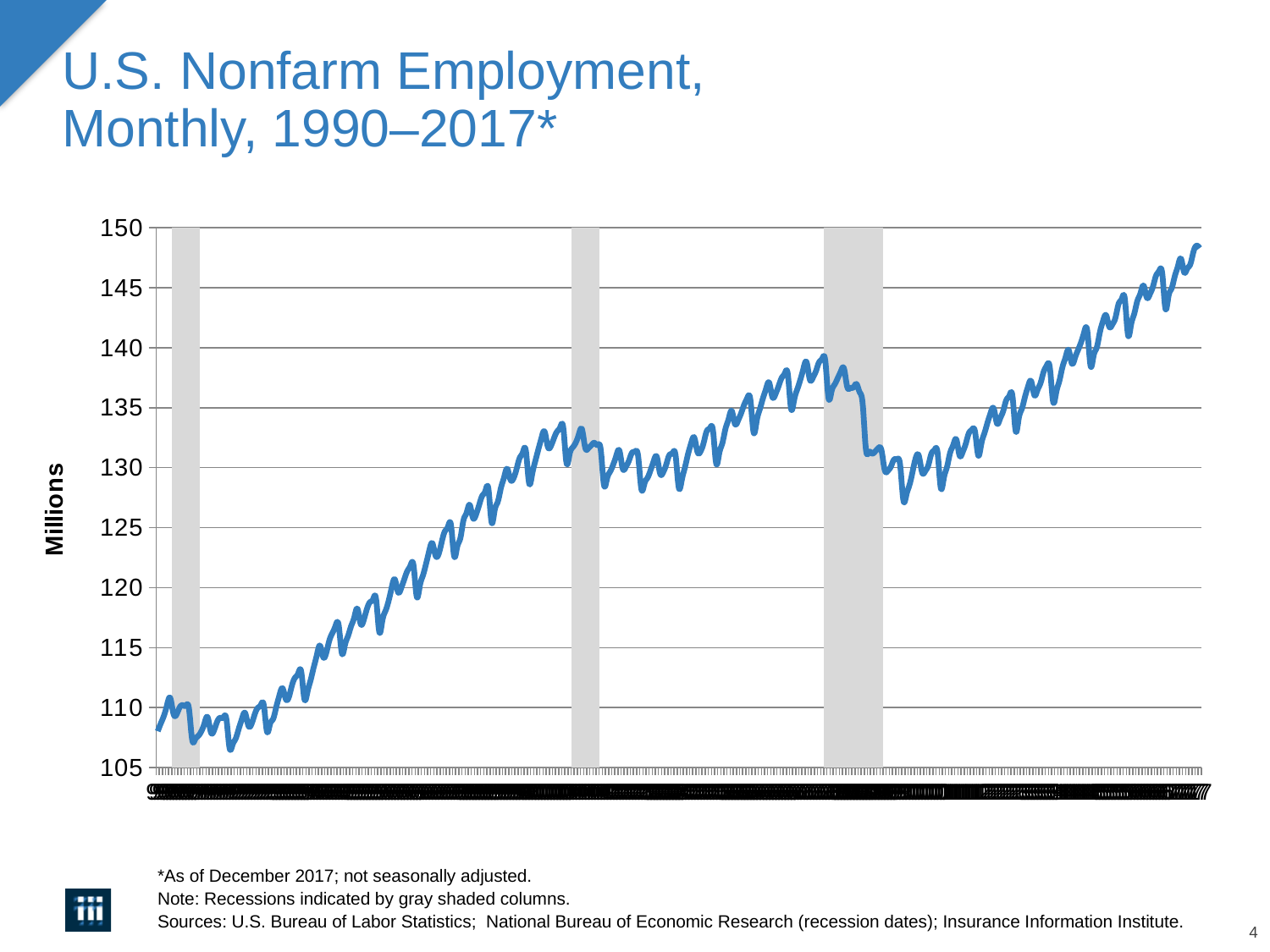
How many gray shaded recession columns are shown on the chart? 3 What kind of chart is shown on the slide? line chart What unit is given on the vertical axis of the chart? Millions Is the value at the start of the series (1990) greater or less than 115? less Is the value at the end of the series greater or less than 150? less Is the lowest value reached after the third gray shaded recession column greater or less than 130? less Does the series reach its highest value at the beginning or at the end of the period shown? end Overall, does U.S. nonfarm employment rise or fall from 1990 to 2017 in this chart? rise Which is larger: the value at the start of the series in 1990 or the value at the end of the series in 2017? 2017